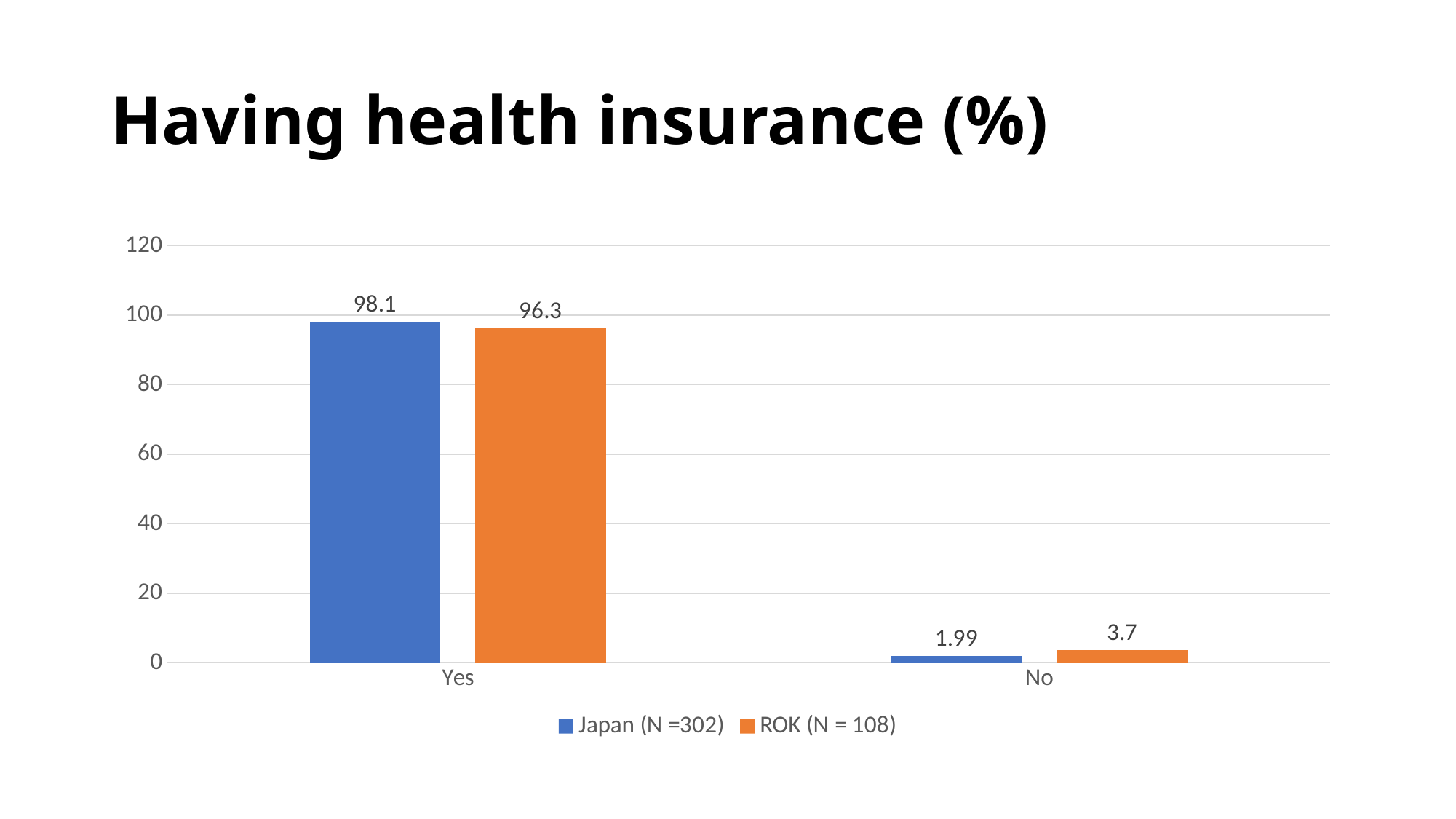
What is the difference between the ROK and Japan values in the No category? 1.71 What is the difference between the Japan and ROK values in the Yes category? 1.8 What kind of chart is shown on the slide? Bar chart Which series has the higher value in the Yes category? Japan (N =302) What is the value for ROK (N = 108) in the Yes category? 96.3 What is the value for Japan (N =302) in the No category? 1.99 How many series does the legend list? 2 How many categories are shown on the x axis? 2 Which series has the higher value in the No category? ROK (N = 108) What is the value for ROK (N = 108) in the No category? 3.7 What is the value for Japan (N =302) in the Yes category? 98.1 What is the title of the slide? Having health insurance (%)